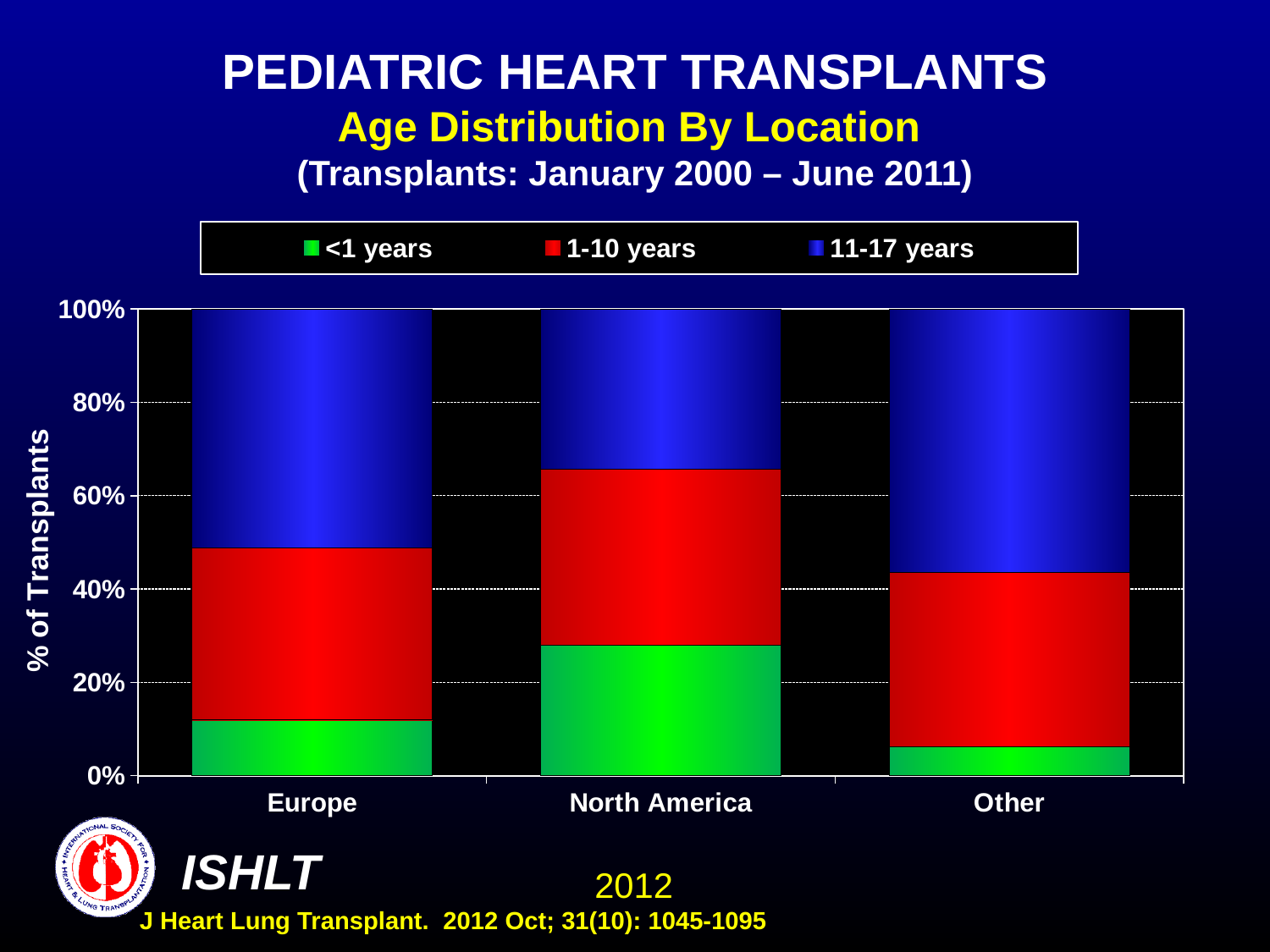
How many age groups does the legend list? 3 Is the <1 years share larger for Europe or for Other? Europe What kind of chart is shown on the slide? bar chart Is the <1 years share for North America greater or less than 20%? greater What is the label on the y axis of the chart? % of Transplants Which location has the smallest share of transplants in the 11-17 years age group? North America Which location has the smallest share of transplants in the <1 years age group? Other Is the 11-17 years share for North America greater or less than 40%? less How many locations are shown on the x axis of the chart? 3 Is the <1 years share for Europe greater or less than 20%? less Which location has the largest share of transplants in the <1 years age group? North America